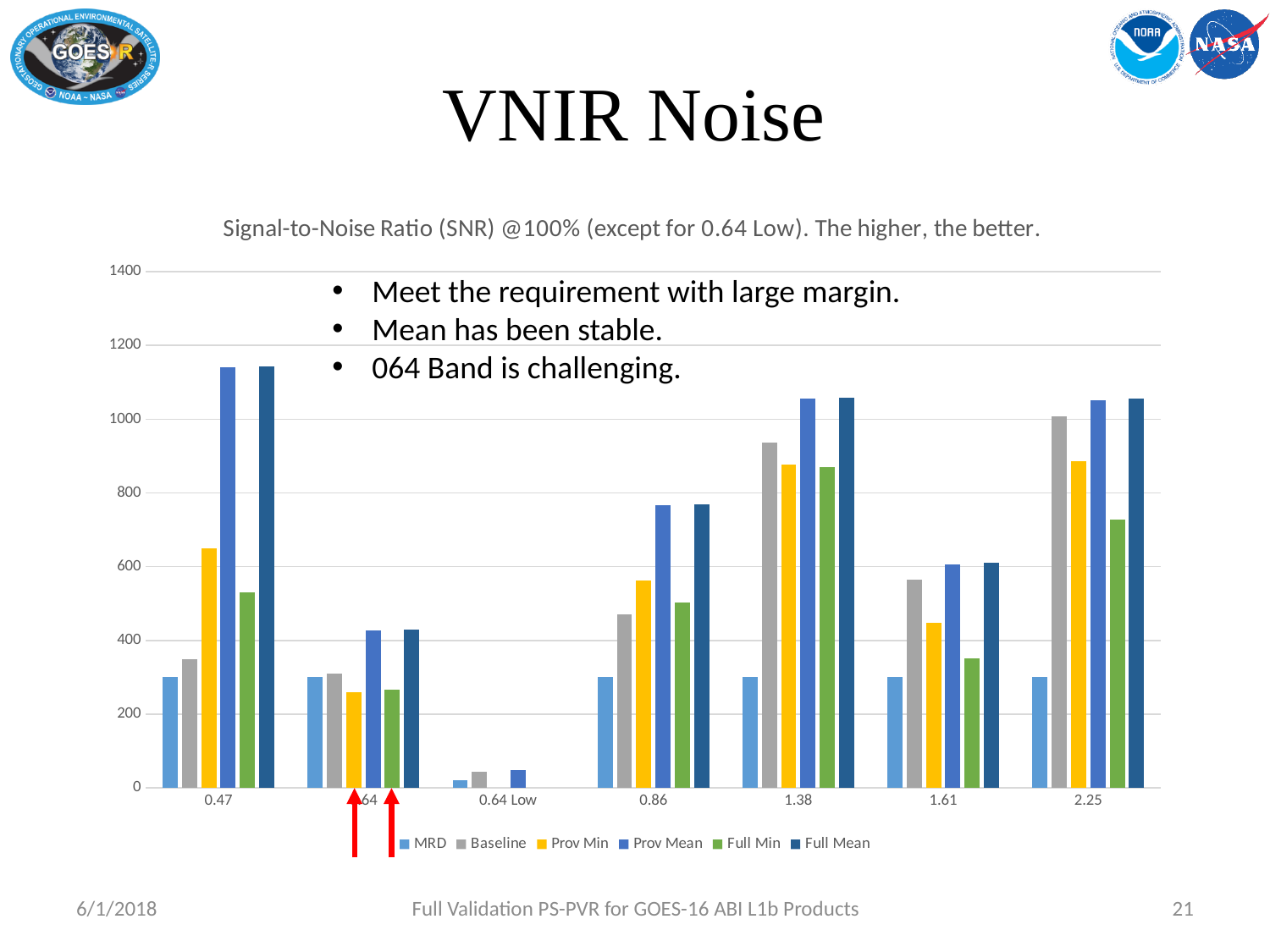
Is the Baseline value for 1.38 greater or less than 800? greater Which is larger: the Prov Mean value for 0.47 or the Prov Mean value for 2.25? 0.47 Is the Full Min value for 0.86 greater or less than 600? less Which category has the highest Full Mean value? 0.47 How many categories are shown along the x axis? 7 How many series does the legend list? 6 Is the Prov Mean value for 0.47 greater or less than 1000? greater Which is larger: the Full Min value for 1.38 or the Full Min value for 1.61? 1.38 Which category has the lowest Prov Mean value? 0.64 Low What kind of chart is shown on the slide? bar chart What is the title of the chart? Signal-to-Noise Ratio (SNR) @100% (except for 0.64 Low). The higher, the better.